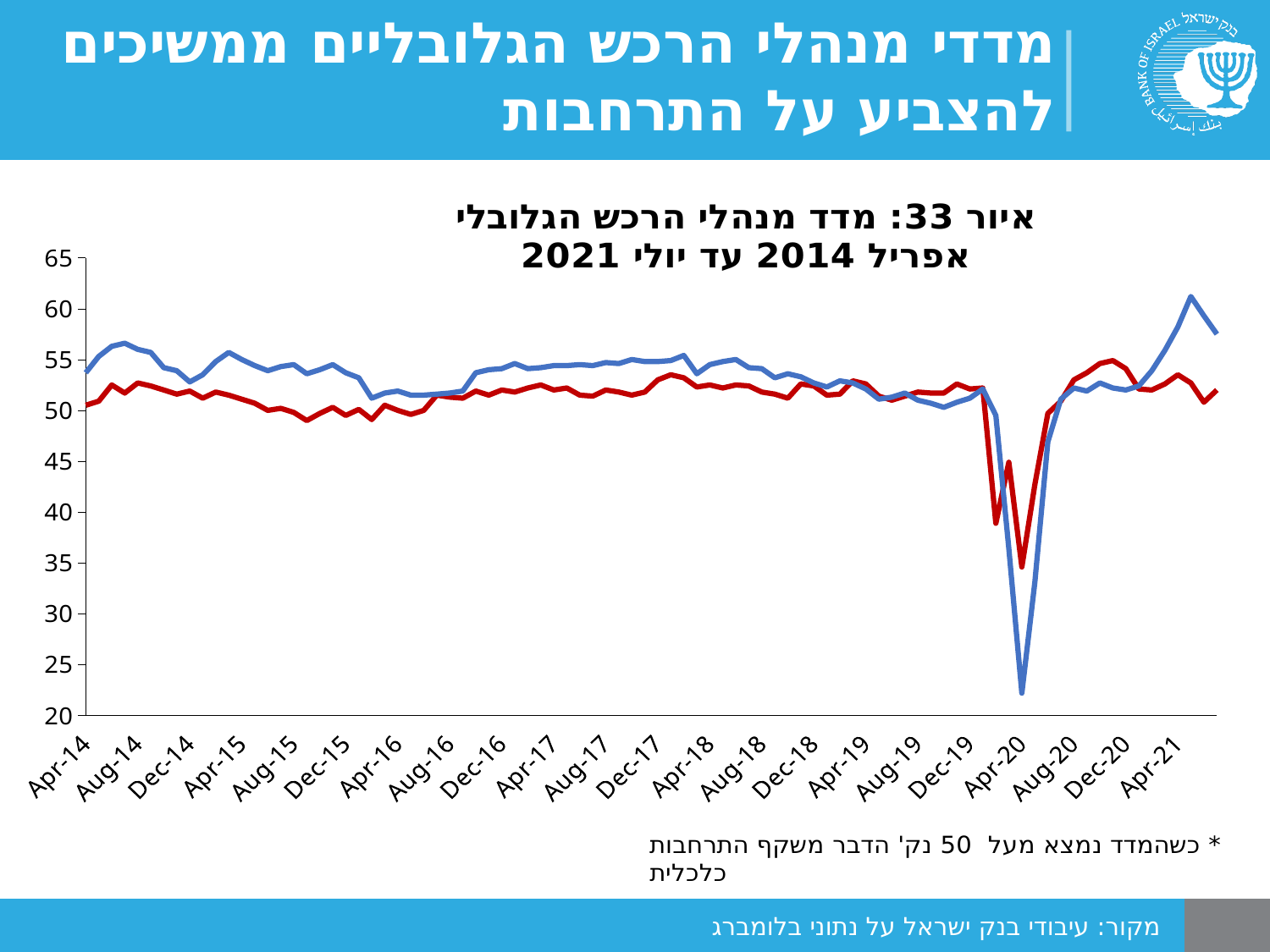
Is the lowest value of the red line greater or less than 40? less What type of chart is shown on the slide? line chart Is the value of the blue line at Apr-21 greater or less than 55? greater In which month does the blue line reach its lowest value? Apr-20 What is the title of the chart? איור 33: מדד מנהלי הרכש הגלובלי אפריל 2014 עד יולי 2021 Is the lowest value of the blue line greater or less than 25? less How many lines are plotted on the chart? 2 According to the footnote, above what value does the index reflect economic expansion? 50 At Apr-20, which line has the higher value, the blue line or the red line? the red line Does the blue line rise or fall between Dec-19 and Apr-20? fall In which month does the red line reach its lowest value? Apr-20